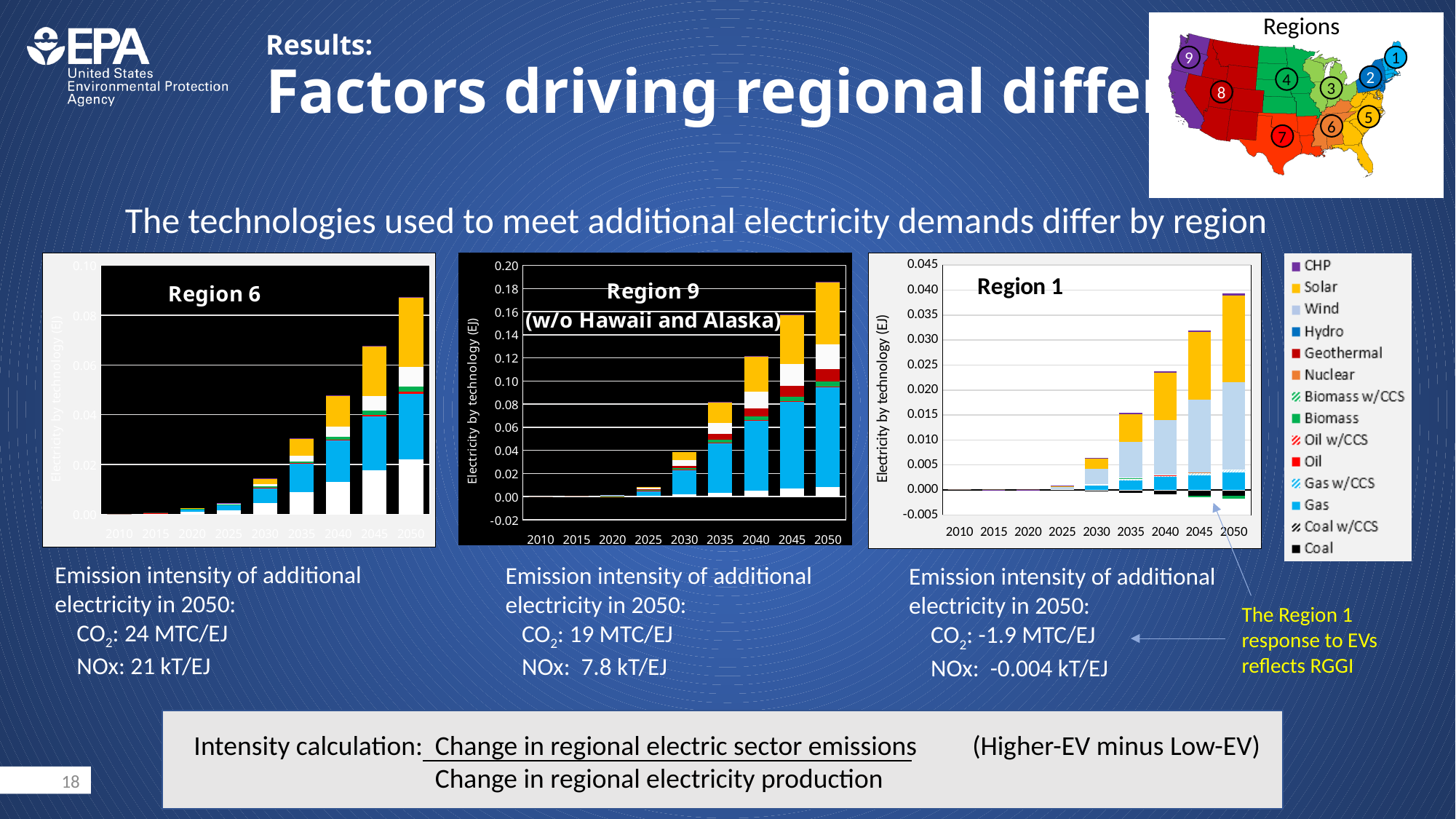
How many years are shown on the x axis of the Region 9 chart? 9 What kind of chart is the Region 1 chart? Stacked bar chart In the Region 6 chart, which year has the tallest stacked bar? 2050 In the Region 1 chart, which stacked bar is taller, 2035 or 2040? 2040 In the Region 1 chart, is the total for 2050 greater or less than 0.035? greater In the Region 9 chart, is the total for 2050 greater or less than 0.16? greater Which technology is listed first (at the top) in the legend? CHP In the Region 9 chart, is the total for 2030 greater or less than 0.06? less In the Region 9 chart, which year has the tallest stacked bar? 2050 In the Region 1 chart, do the stacked bar totals rise or fall from 2010 to 2050? Rise How many technologies does the legend on the right list? 14